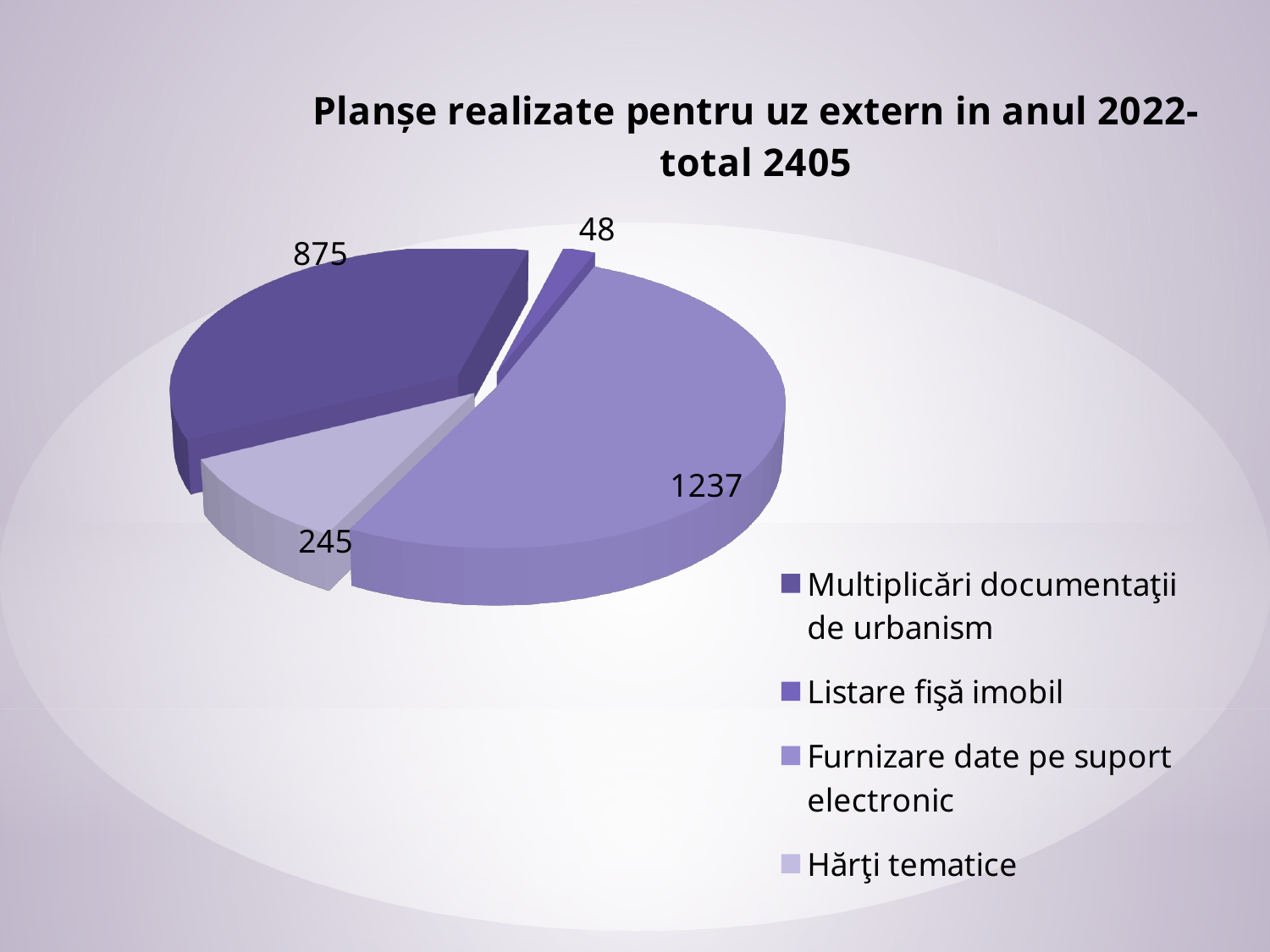
Which category has the smallest slice? Listare fişă imobil What is the value for Furnizare date pe suport electronic? 1237 What is the value for Hărţi tematice? 245 What is the value for Listare fişă imobil? 48 What share of the total does Furnizare date pe suport electronic represent? 51.4% Which category has the largest slice? Furnizare date pe suport electronic What is the difference between the values for Furnizare date pe suport electronic and Multiplicări documentaţii de urbanism? 362 What is the value for Multiplicări documentaţii de urbanism? 875 What kind of chart is shown on the slide? pie chart What is the title of the chart? Planșe realizate pentru uz extern in anul 2022- total 2405 How many categories does the pie chart have? 4 Which is larger, Hărţi tematice or Listare fişă imobil? Hărţi tematice